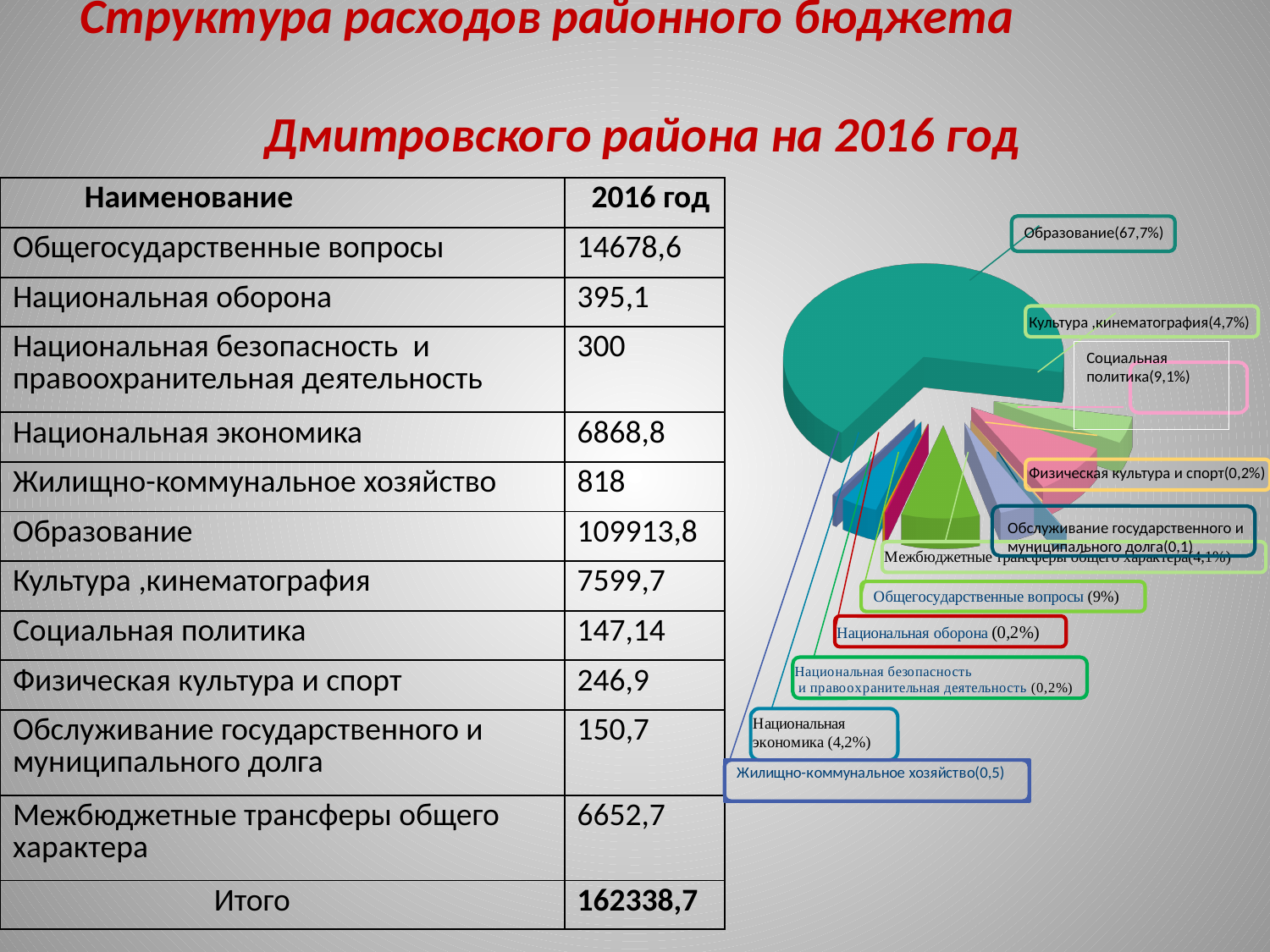
What share does Жилищно-коммунальное хозяйство have in the pie chart? 0,5 What share does Национальная экономика have in the pie chart? 4,2% Which category has the largest slice in the pie chart? Образование What share does Социальная политика have in the pie chart? 9,1% What kind of chart is shown on the slide? pie chart Which category has the smallest share in the pie chart? Обслуживание государственного и муниципального долга What share does Культура, кинематография have in the pie chart? 4,7% Which has the larger share in the pie chart, Образование or Социальная политика? Образование What share does Образование have in the pie chart? 67,7% What share does Общегосударственные вопросы have in the pie chart? 9% How many categories are labelled in the pie chart? 11 What is the difference between the shares of Образование and Социальная политика in the pie chart? 58,6%